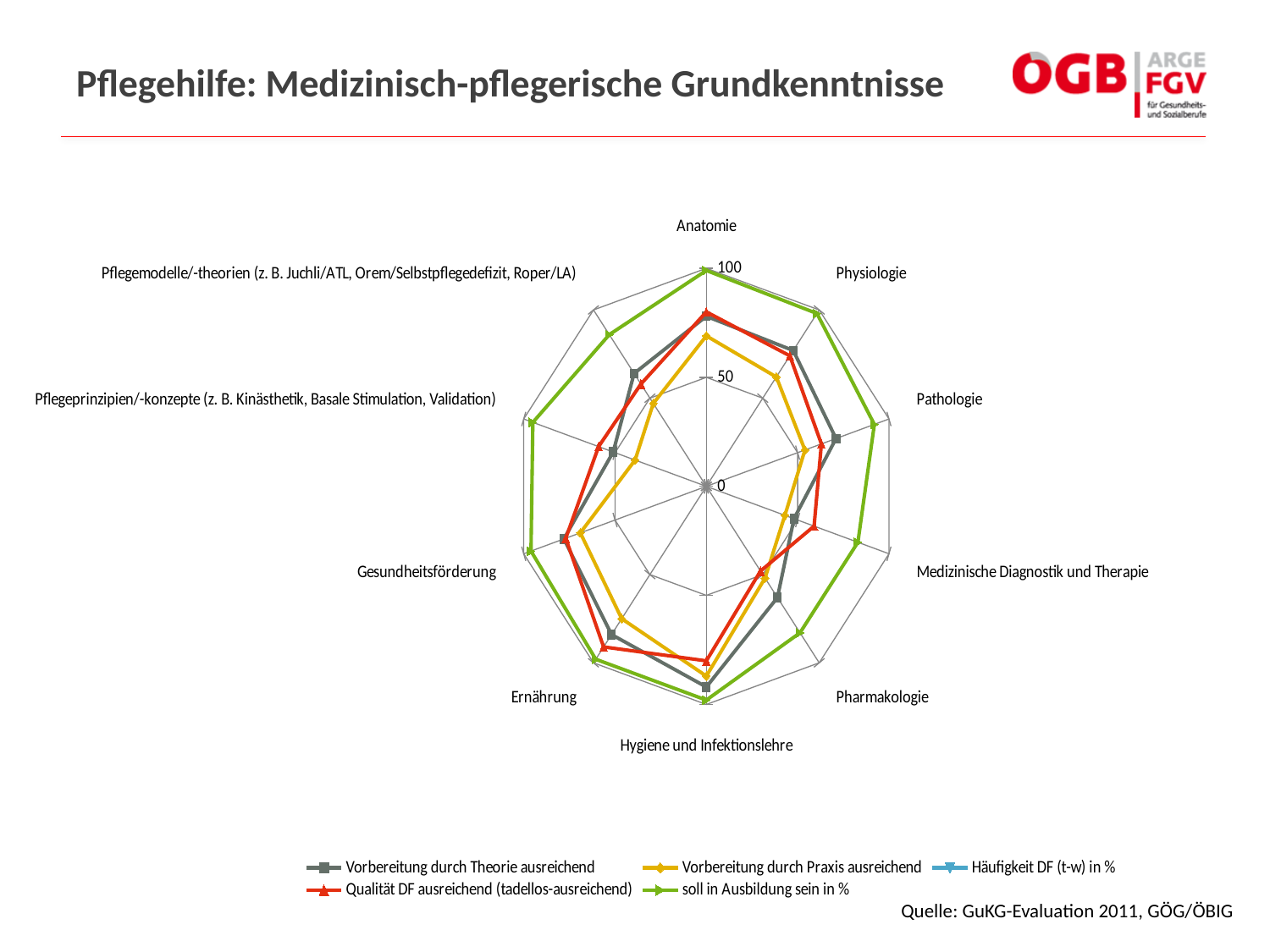
How many series does the legend list? 5 For Gesundheitsförderung, which is larger: 'soll in Ausbildung sein in %' or 'Vorbereitung durch Praxis ausreichend'? soll in Ausbildung sein in % How many categories (axes) does the radar chart have? 10 Is the value of 'Vorbereitung durch Praxis ausreichend' for Anatomie greater or less than 50? greater For Anatomie, which is larger: 'Vorbereitung durch Theorie ausreichend' or 'Vorbereitung durch Praxis ausreichend'? Vorbereitung durch Theorie ausreichend What kind of chart is shown on the slide? radar chart Is the value of 'soll in Ausbildung sein in %' for Anatomie greater or less than 50? greater What is the title of the slide containing the chart? Pflegehilfe: Medizinisch-pflegerische Grundkenntnisse Which colour is used for the series 'soll in Ausbildung sein in %'? green For Anatomie, which is larger: 'soll in Ausbildung sein in %' or 'Vorbereitung durch Praxis ausreichend'? soll in Ausbildung sein in % Is the value of 'soll in Ausbildung sein in %' for Medizinische Diagnostik und Therapie greater or less than 50? greater